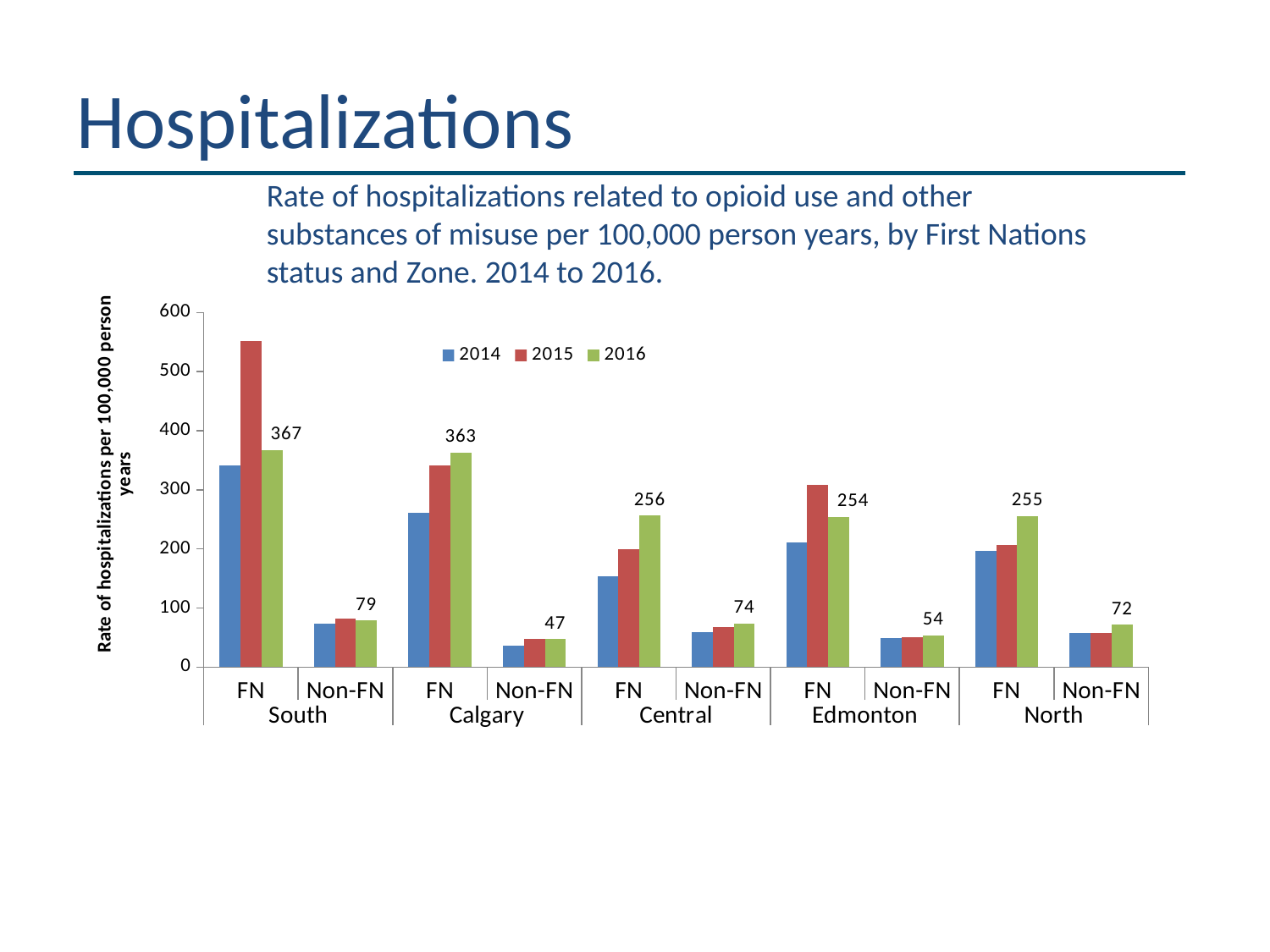
Which category has the lowest 2016 value? Non-FN, Calgary Which is larger in 2016: the Non-FN value for Central or the Non-FN value for Edmonton? Non-FN, Central Is the 2014 value for FN in the Calgary zone greater or less than 300? less What kind of chart is shown on the slide? bar chart Do the values for FN in the Central zone rise or fall from 2014 to 2016? rise How many series does the legend list? 3 What is the 2016 value for Non-FN in the Calgary zone? 47 What is the 2016 value for Non-FN in the North zone? 72 Is the 2015 value for FN in the South zone greater or less than 500? greater What is the 2016 value for FN in the South zone? 367 What is the difference between the 2016 values for FN and Non-FN in the Central zone? 182 What is the 2016 value for FN in the Edmonton zone? 254